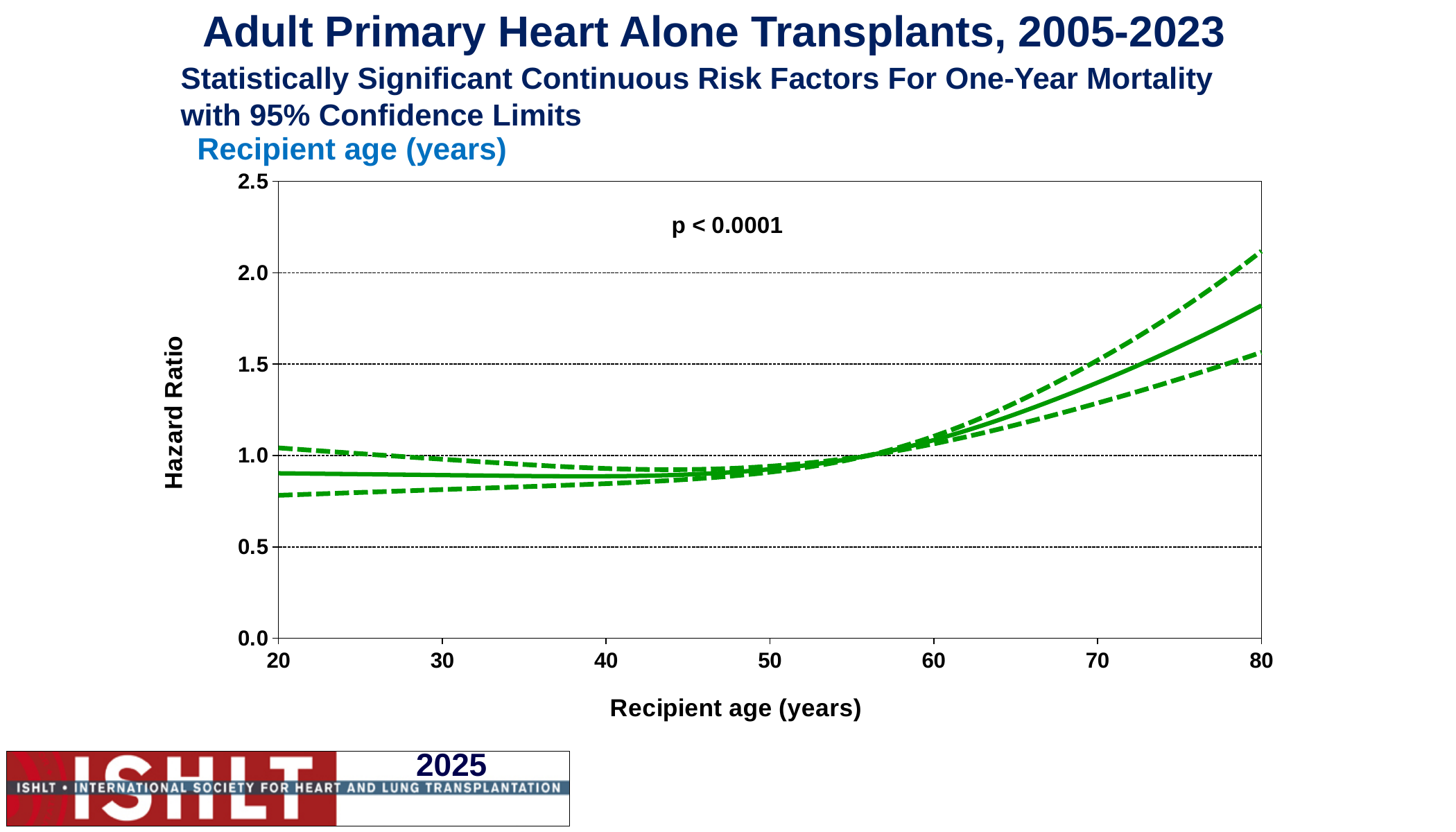
Is the hazard ratio (solid line) at recipient age 70 greater or less than 1.0? greater Is the lower 95% confidence limit at recipient age 20 greater or less than 1.0? less How many lines are plotted on the chart? 3 What kind of chart is shown on the slide? Line chart Is the upper 95% confidence limit at recipient age 80 greater or less than 2.0? greater Does the hazard ratio rise or fall as recipient age increases from 20 to 80 years? Rises Which recipient age has the larger hazard ratio on the solid line, 20 years or 80 years? 80 years What is the label of the y-axis? Hazard Ratio What is the highest value shown on the y-axis? 2.5 What p-value is printed on the chart? p < 0.0001